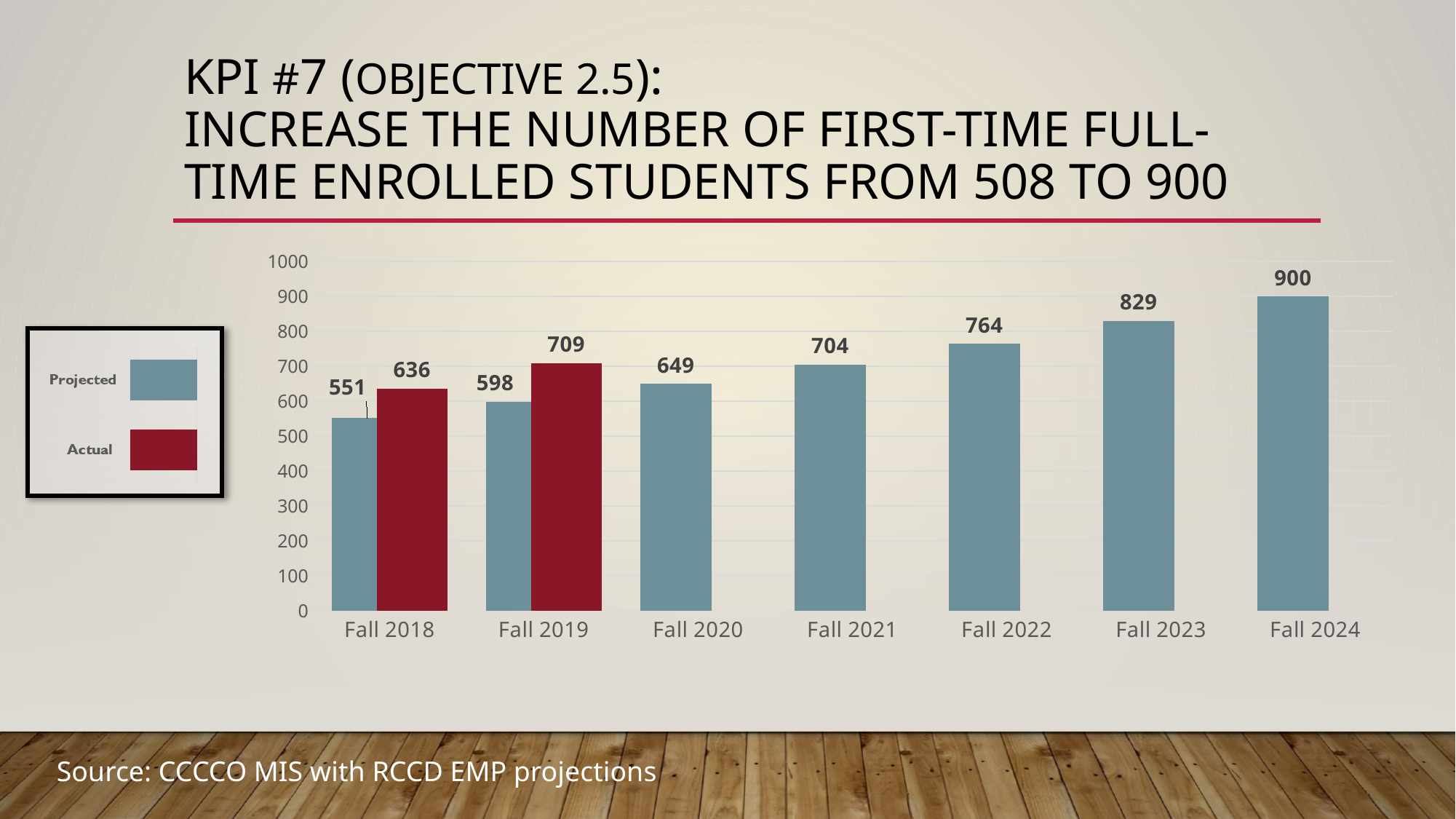
Which is larger for Fall 2019, the projected value or the actual value? Actual How many years are shown on the x axis? 7 Which year has the highest projected value? Fall 2024 What is the projected value for Fall 2018? 551 How many series does the legend list? 2 What is the projected value for Fall 2022? 764 What kind of chart is shown on the slide? Bar chart Do the projected values rise or fall from Fall 2018 to Fall 2024? Rise What is the projected value for Fall 2024? 900 Which year has the lowest projected value? Fall 2018 What is the difference between the actual and projected values for Fall 2018? 85 What is the actual value for Fall 2019? 709